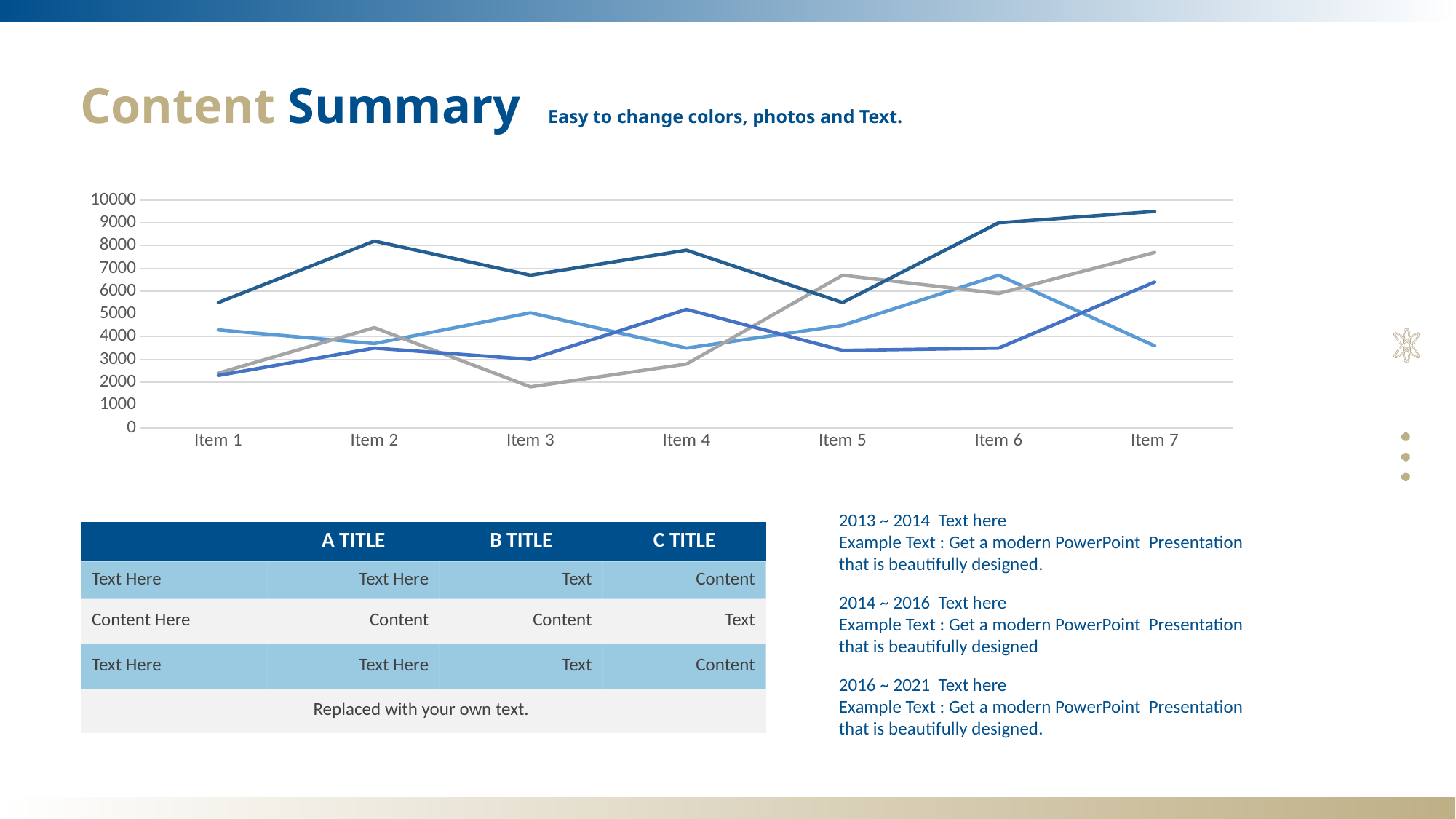
How many categories are shown on the x axis of the chart? 7 What is the highest value shown on the chart's y axis? 10000 At which category does the gray line reach its lowest value? Item 3 Is the value of the dark blue line at Item 7 greater or less than 9000? greater At Item 2, which line has the larger value, the dark blue line or the gray line? the dark blue line At which category does the dark blue line reach its highest value? Item 7 Does the dark blue line rise or fall from Item 5 to Item 7? rise Is the value of the light blue line at Item 6 greater or less than 6000? greater What kind of chart is shown on the slide? line chart Is the value of the gray line at Item 3 greater or less than 2000? less How many lines are plotted on the chart? 4 What is the label of the first category on the x axis? Item 1